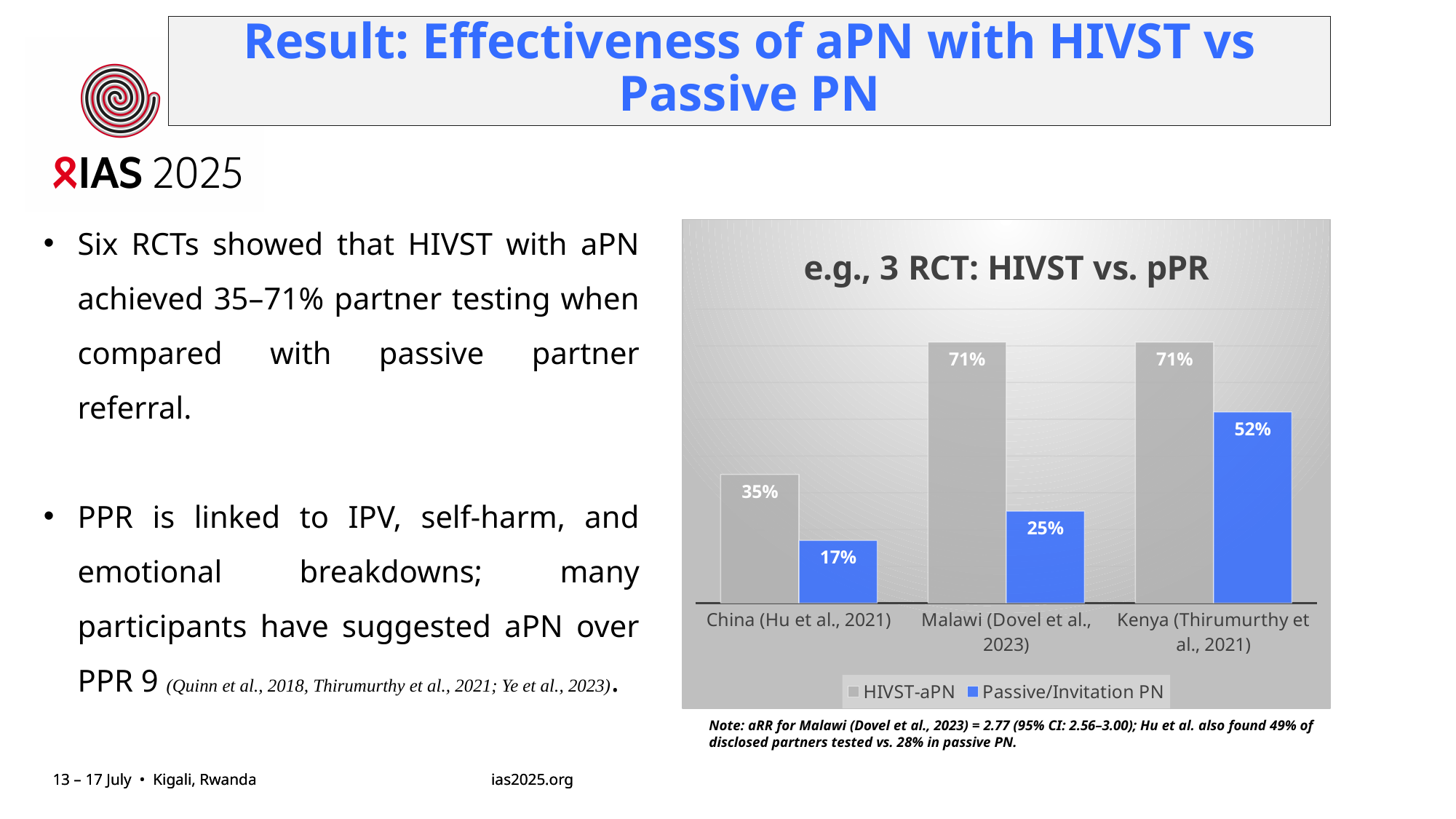
What is the Passive/Invitation PN value for Malawi (Dovel et al., 2023)? 25% Which is larger for Kenya (Thirumurthy et al., 2021): the HIVST-aPN value or the Passive/Invitation PN value? HIVST-aPN What is the difference between the HIVST-aPN and Passive/Invitation PN values for Malawi (Dovel et al., 2023)? 46% Which country has the highest Passive/Invitation PN value? Kenya (Thirumurthy et al., 2021) How many countries (categories) are shown on the x axis of the chart? 3 What is the difference between the HIVST-aPN and Passive/Invitation PN values for China (Hu et al., 2021)? 18% What is the HIVST-aPN value for China (Hu et al., 2021)? 35% What kind of chart is shown on the slide? Bar chart How many series does the chart legend list? 2 What is the Passive/Invitation PN value for Kenya (Thirumurthy et al., 2021)? 52% Which country has the lowest Passive/Invitation PN value? China (Hu et al., 2021) What is the title of the chart? e.g., 3 RCT: HIVST vs. pPR